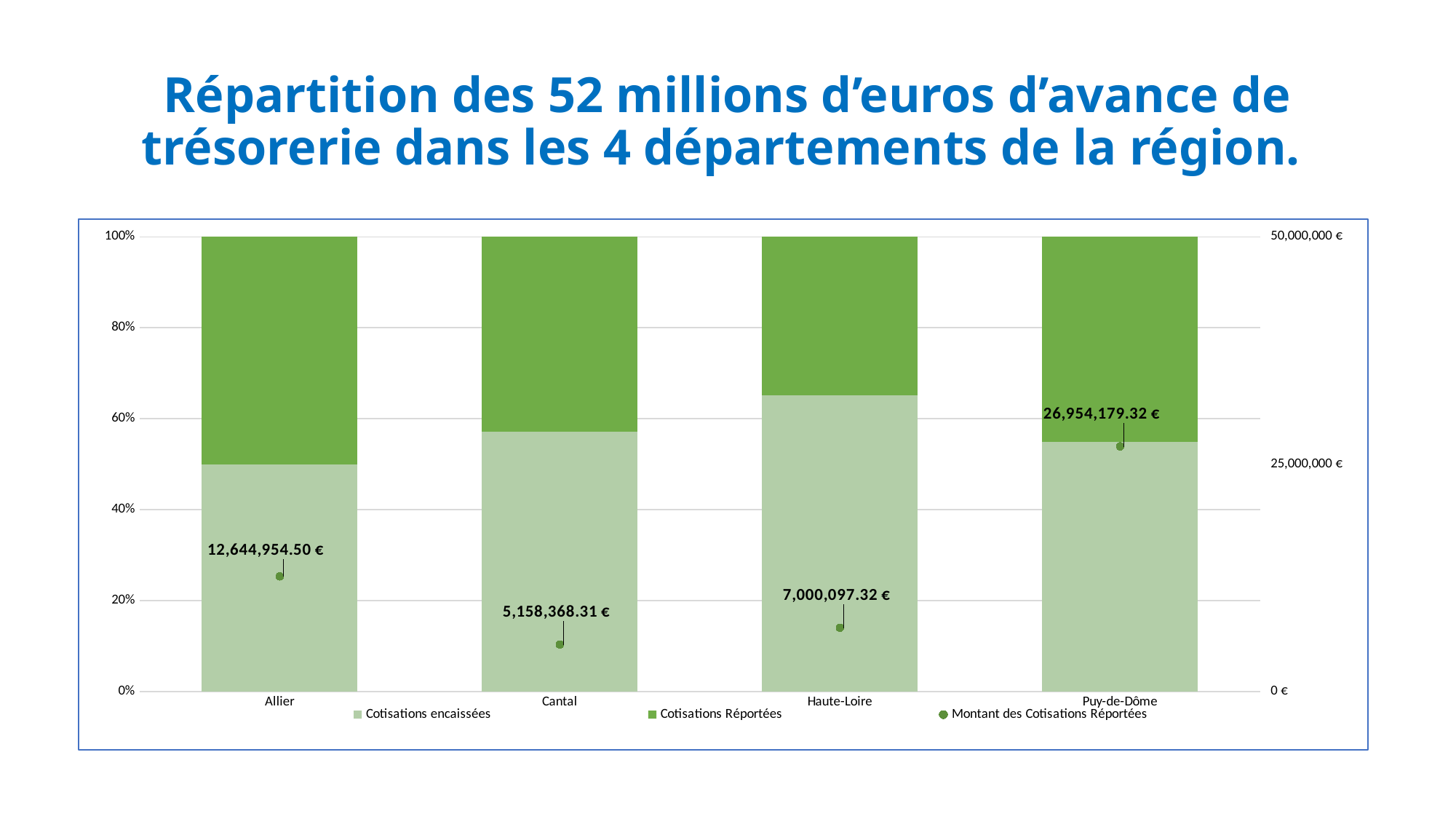
Which department has the highest Montant des Cotisations Réportées? Puy-de-Dôme What is the Montant des Cotisations Réportées for Puy-de-Dôme? 26,954,179.32 € Which is larger, the Montant des Cotisations Réportées for Allier or for Haute-Loire? Allier How many series does the legend list? 3 Is the Cotisations encaissées share for Cantal greater or less than 60%? less What is the Montant des Cotisations Réportées for Allier? 12,644,954.50 € What is the Montant des Cotisations Réportées for Cantal? 5,158,368.31 € Which department has the lowest Montant des Cotisations Réportées? Cantal What kind of chart is shown on the slide? Stacked bar chart How many departments are shown on the x axis? 4 Is the Cotisations encaissées share for Haute-Loire greater or less than 60%? greater What is the difference between the Montant des Cotisations Réportées for Puy-de-Dôme and Allier? 14,309,224.82 €